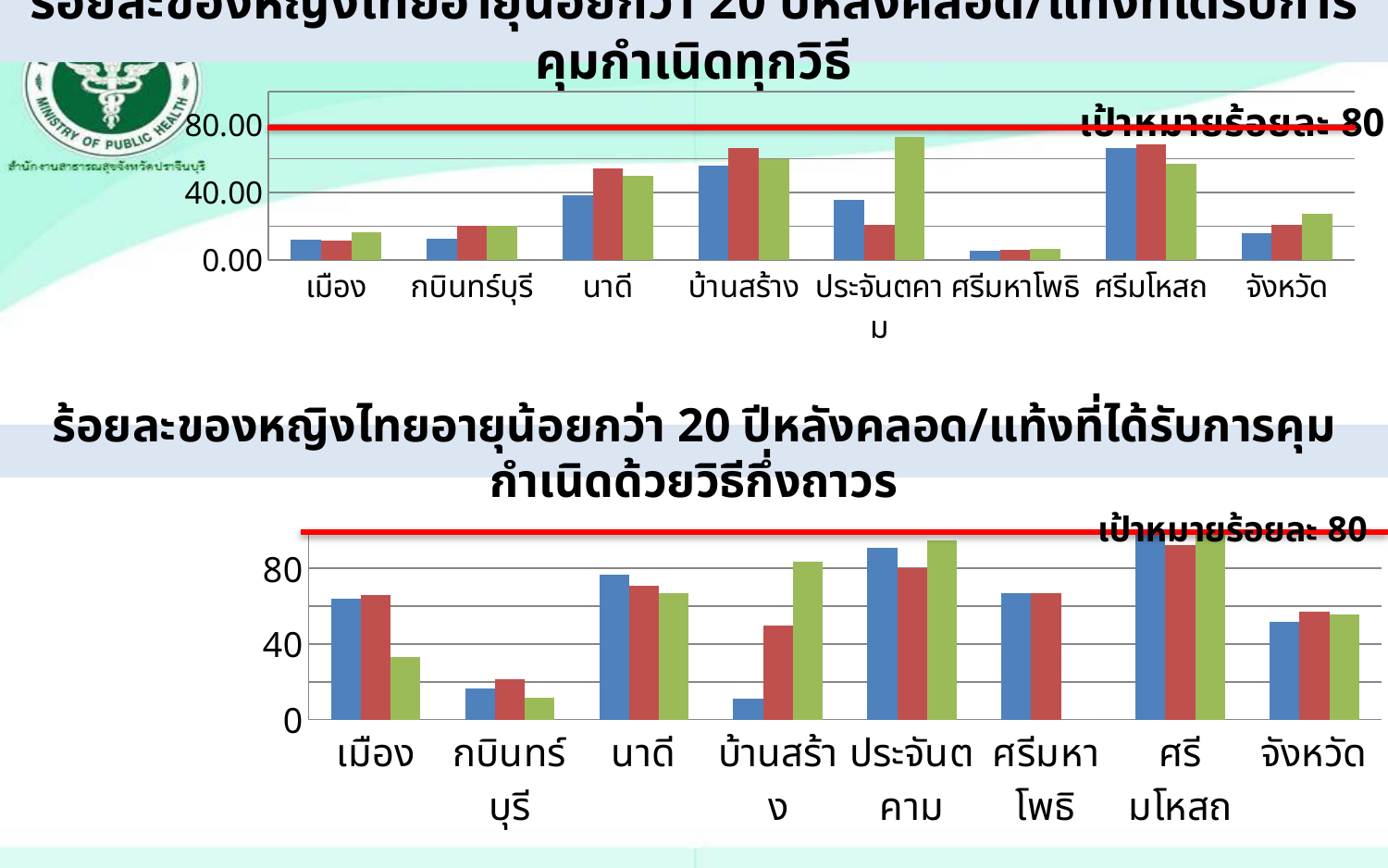
What target percentage does the red horizontal line on each chart mark? 80 How many bars are plotted for each category in the bottom chart? 3 In the bottom chart, which is larger: the green bar for เมือง or the green bar for นาดี? นาดี In the bottom chart, is the red bar for กบินทร์บุรี greater or less than 40? less What kind of chart is the top chart on the slide? bar chart In the top chart, is the blue bar for เมือง greater or less than 40.00? less How many categories are shown on the x axis of the top chart? 8 In the top chart, is the green bar for บ้านสร้าง greater or less than 40.00? greater How many categories are shown on the x axis of the bottom chart? 8 In the top chart, which category has the lowest bars overall? ศรีมหาโพธิ